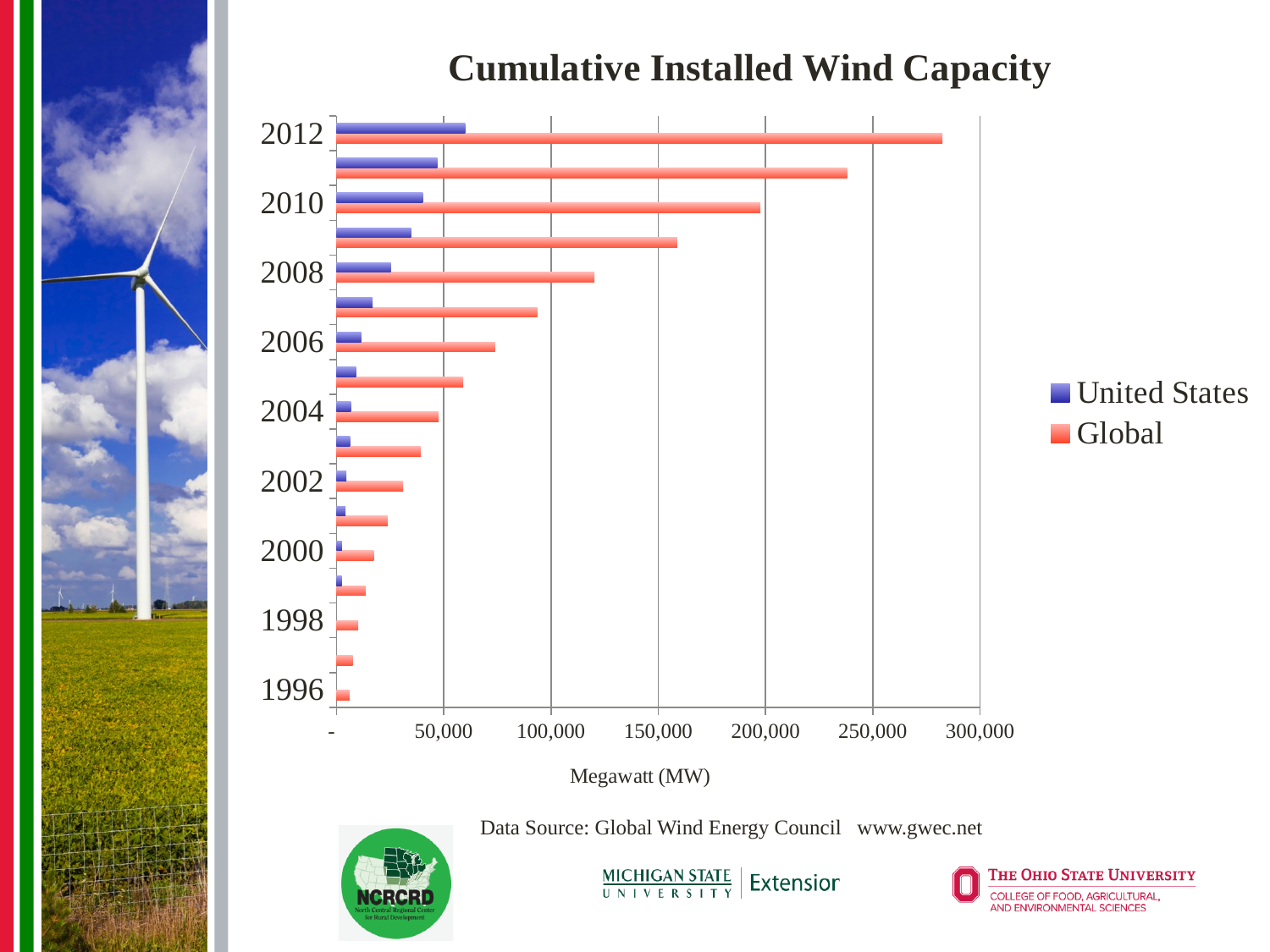
In which year is the Global cumulative installed wind capacity highest? 2012 Is the Global value for 2008 greater or less than 100,000? greater How many series does the legend list? 2 In 2012, which is larger, the United States value or the Global value? Global What unit is shown on the x axis label? Megawatt (MW) Is the Global value for 2012 greater or less than 250,000? greater Is the Global value for 2002 greater or less than 50,000? less Do the Global values rise or fall from 1996 to 2012? rise What is the title of the chart? Cumulative Installed Wind Capacity What kind of chart is shown on the slide? bar chart